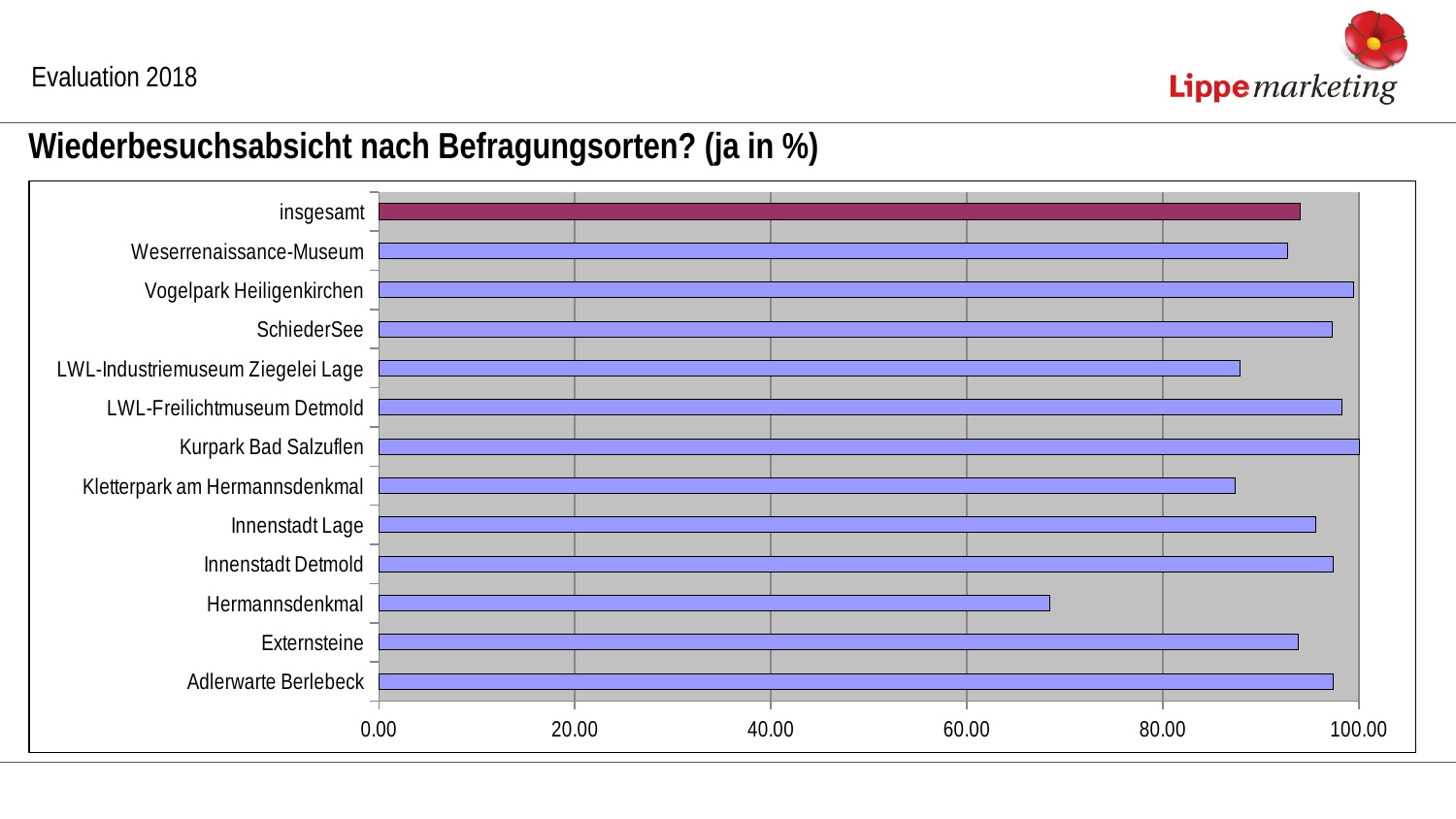
Is the value for insgesamt greater or less than 60.00? greater Which is larger, the value for Innenstadt Lage or the value for Kletterpark am Hermannsdenkmal? Innenstadt Lage Which is larger, the value for Externsteine or the value for Hermannsdenkmal? Externsteine What is the title of the chart? Wiederbesuchsabsicht nach Befragungsorten? (ja in %) Which category has the lowest value? Hermannsdenkmal Which category's bar is shown in a different colour from the others? insgesamt Is the value for LWL-Industriemuseum Ziegelei Lage greater or less than 80.00? greater Which is larger, the value for Vogelpark Heiligenkirchen or the value for Weserrenaissance-Museum? Vogelpark Heiligenkirchen What kind of chart is shown on the slide? bar chart Is the value for Hermannsdenkmal greater or less than 80.00? less How many categories are shown on the chart? 13